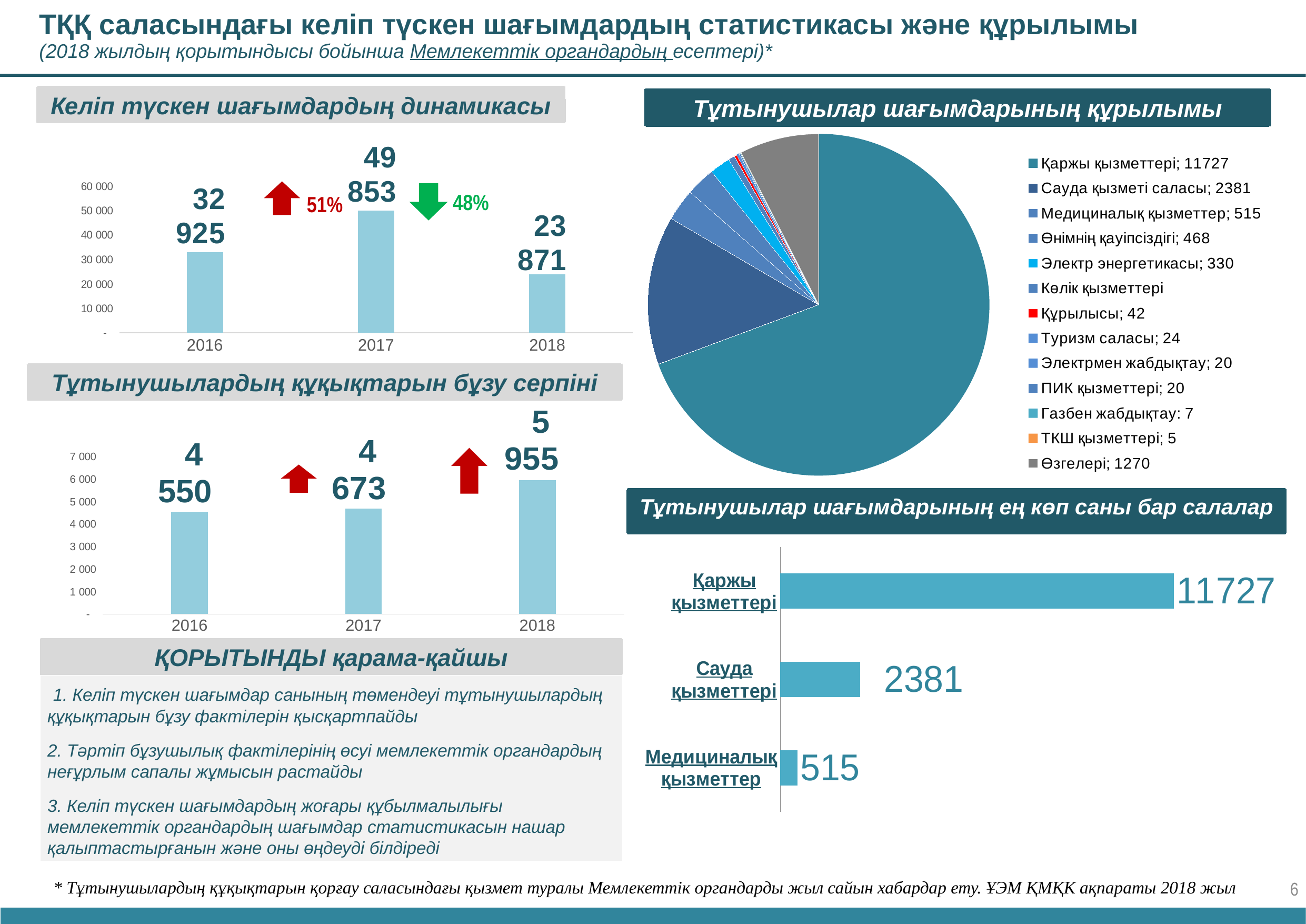
What kind of chart is the one titled "Тұтынушылар шағымдарының ең көп саны бар салалар"? bar chart In the chart titled "Тұтынушылардың құқықтарын бұзу серпіні", how many years are shown on the x axis? 3 In the chart titled "Келіп түскен шағымдардың динамикасы", what is the value for 2017? 49 853 In the pie chart titled "Тұтынушылар шағымдарының құрылымы", how many entries does the legend list? 13 In the pie chart titled "Тұтынушылар шағымдарының құрылымы", what value is shown for "Сауда қызметі саласы"? 2381 In the chart titled "Тұтынушылардың құқықтарын бұзу серпіні", what is the value for 2018? 5 955 In the chart titled "Келіп түскен шағымдардың динамикасы", what is the difference between the 2017 and 2018 values? 25 982 In the pie chart titled "Тұтынушылар шағымдарының құрылымы", which category has the largest slice? Қаржы қызметтері In the chart titled "Тұтынушылардың құқықтарын бұзу серпіні", what is the difference between the 2017 and 2016 values? 123 In the chart titled "Келіп түскен шағымдардың динамикасы", which year has the lowest value? 2018 In the chart titled "Тұтынушылар шағымдарының ең көп саны бар салалар", which is larger: "Сауда қызметтері" or "Медициналық қызметтер"? Сауда қызметтері In the chart titled "Тұтынушылардың құқықтарын бұзу серпіні", do the values rise or fall from 2016 to 2018? rise